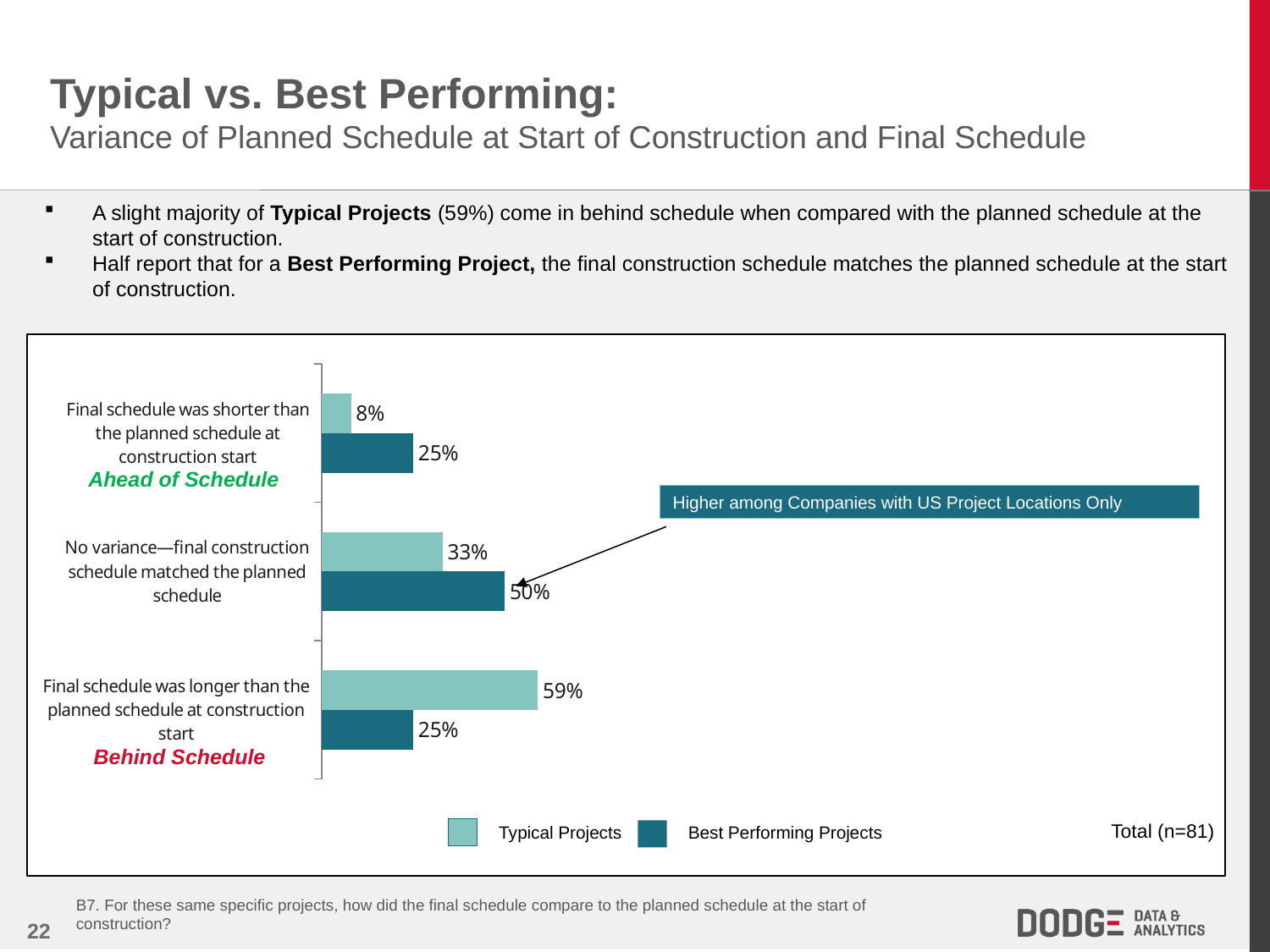
For the 'No variance' category, which series has the larger value: Typical Projects or Best Performing Projects? Best Performing Projects What type of chart is shown on the slide? Bar chart What percentage of Best Performing Projects were ahead of schedule? 25% What percentage of Typical Projects had a final schedule longer than the planned schedule at construction start? 59% Which category has the highest value for Typical Projects? Final schedule was longer than the planned schedule at construction start What percentage of Typical Projects had a final schedule shorter than the planned schedule? 8% What percentage of Best Performing Projects had no variance between the final and planned schedule? 50% How many series does the legend list? 2 What is the difference between Typical Projects and Best Performing Projects for the 'Behind Schedule' category? 34% How many categories are shown on the chart? 3 Which category has the lowest value for Typical Projects? Final schedule was shorter than the planned schedule at construction start What is the total sample size (n) noted on the chart? 81